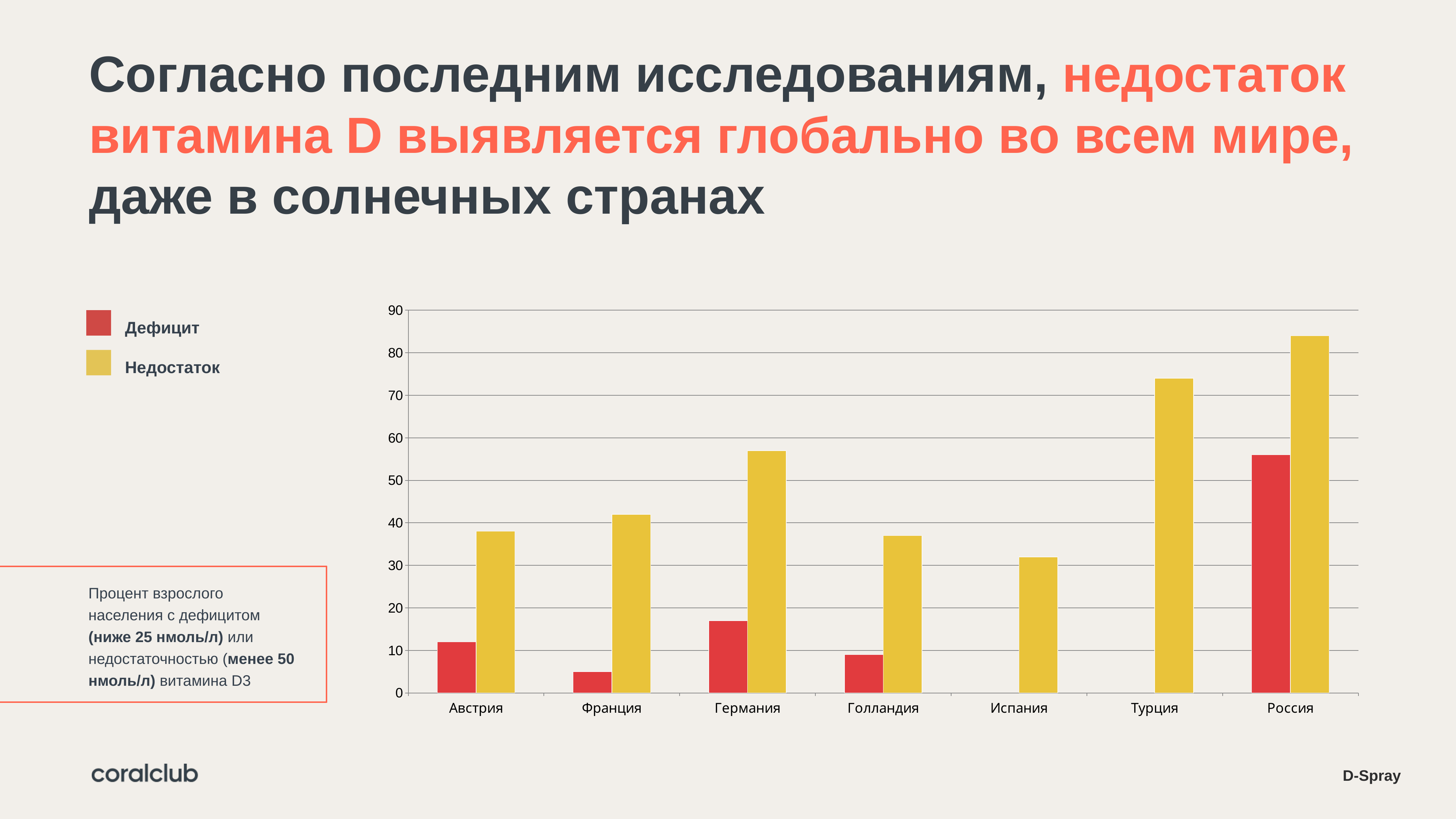
Which is larger: the Недостаток value for Германия or for Франция? Германия Is the Дефицит value for Россия greater or less than 50? greater How many countries are shown on the x axis of the chart? 7 What kind of chart is shown on the slide? bar chart Is the Дефицит value for Германия greater or less than 20? less How many series does the chart's legend list? 2 Which country has the highest value for Дефицит? Россия Which country has the lowest value for Недостаток? Испания Is the Недостаток value for Россия greater or less than 80? greater Which colour represents the Дефицит series in the chart? red Which country has the highest value for Недостаток? Россия